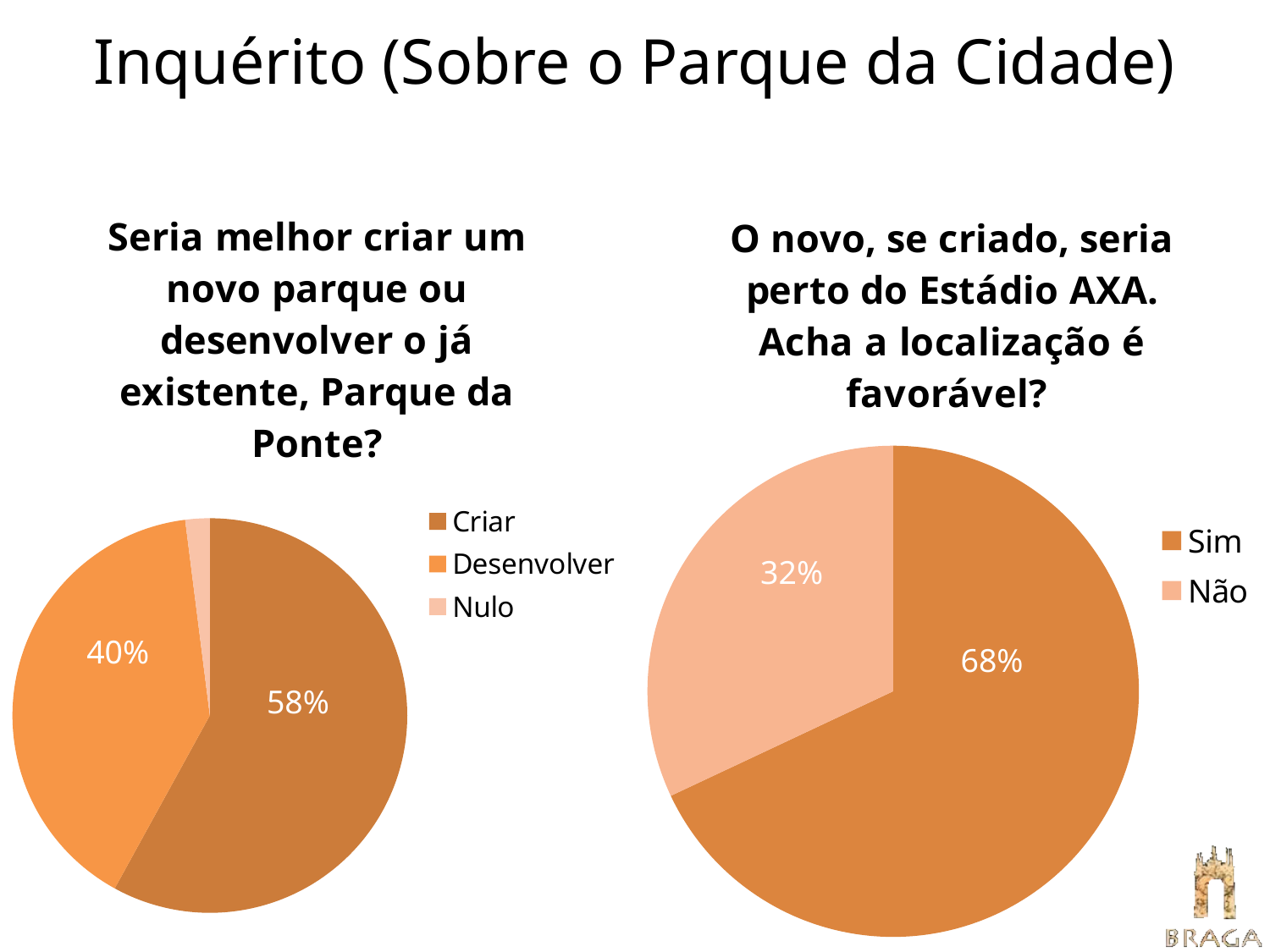
What type of chart is used for both charts on the slide? Pie chart In the right pie chart, which category has the larger share? Sim In the right pie chart ("O novo, se criado, seria perto do Estádio AXA..."), what share of responses is Não? 32% In the right pie chart ("O novo, se criado, seria perto do Estádio AXA..."), what share of responses is Sim? 68% In the left pie chart ("Seria melhor criar um novo parque..."), what share of responses is Criar? 58% How many categories does the legend of the right pie chart list? 2 In the left pie chart, which category has the largest share? Criar In the left pie chart, which category has the smallest share? Nulo In the left pie chart, how many percentage points larger is Criar than Desenvolver? 18 percentage points In the right pie chart, how many percentage points larger is Sim than Não? 36 percentage points In the left pie chart ("Seria melhor criar um novo parque..."), what share of responses is Desenvolver? 40% How many categories does the legend of the left pie chart list? 3